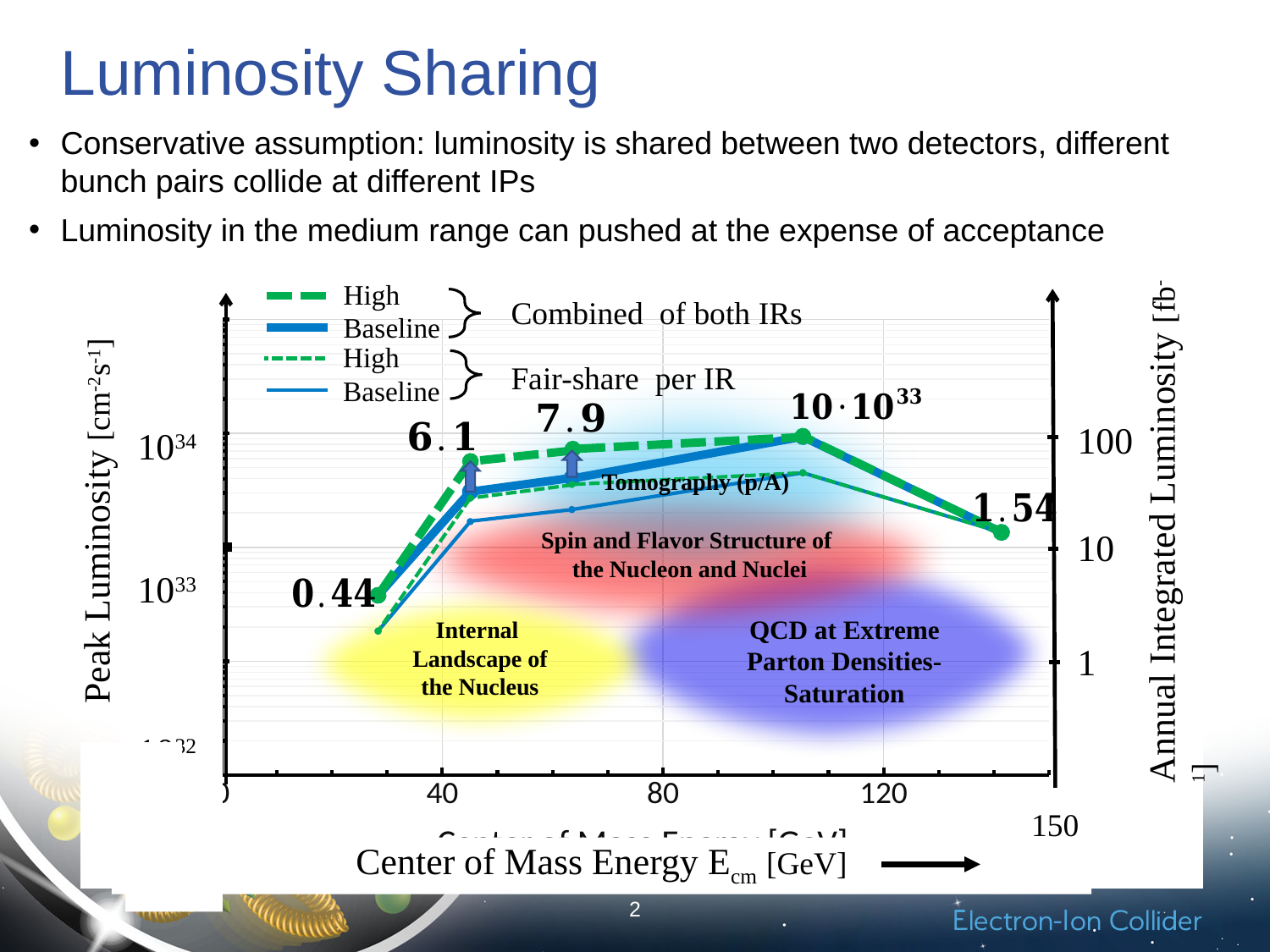
What is the highest data label printed on the chart? 10·10³³ What is the difference between the printed data labels 7.9 and 6.1? 1.8 Do the curves rise or fall between the point near 105 GeV and the point near 140 GeV? fall What is the data label printed on the point near 45 GeV on the top curve? 6.1 Which printed data label is larger, the one near 45 GeV (6.1) or the one near 65 GeV (7.9)? 7.9 What are the four legend entries of the chart? High, Baseline, High, Baseline What is the label on the x axis of the chart? Center of Mass Energy Ecm [GeV] How many series does the chart legend list? 4 What is the data label printed on the rightmost point of the chart, near 140 GeV? 1.54 How many data labels are printed along the top curve of the chart? 5 What is the lowest data label printed on the chart? 0.44 What kind of chart is shown on the slide? line chart